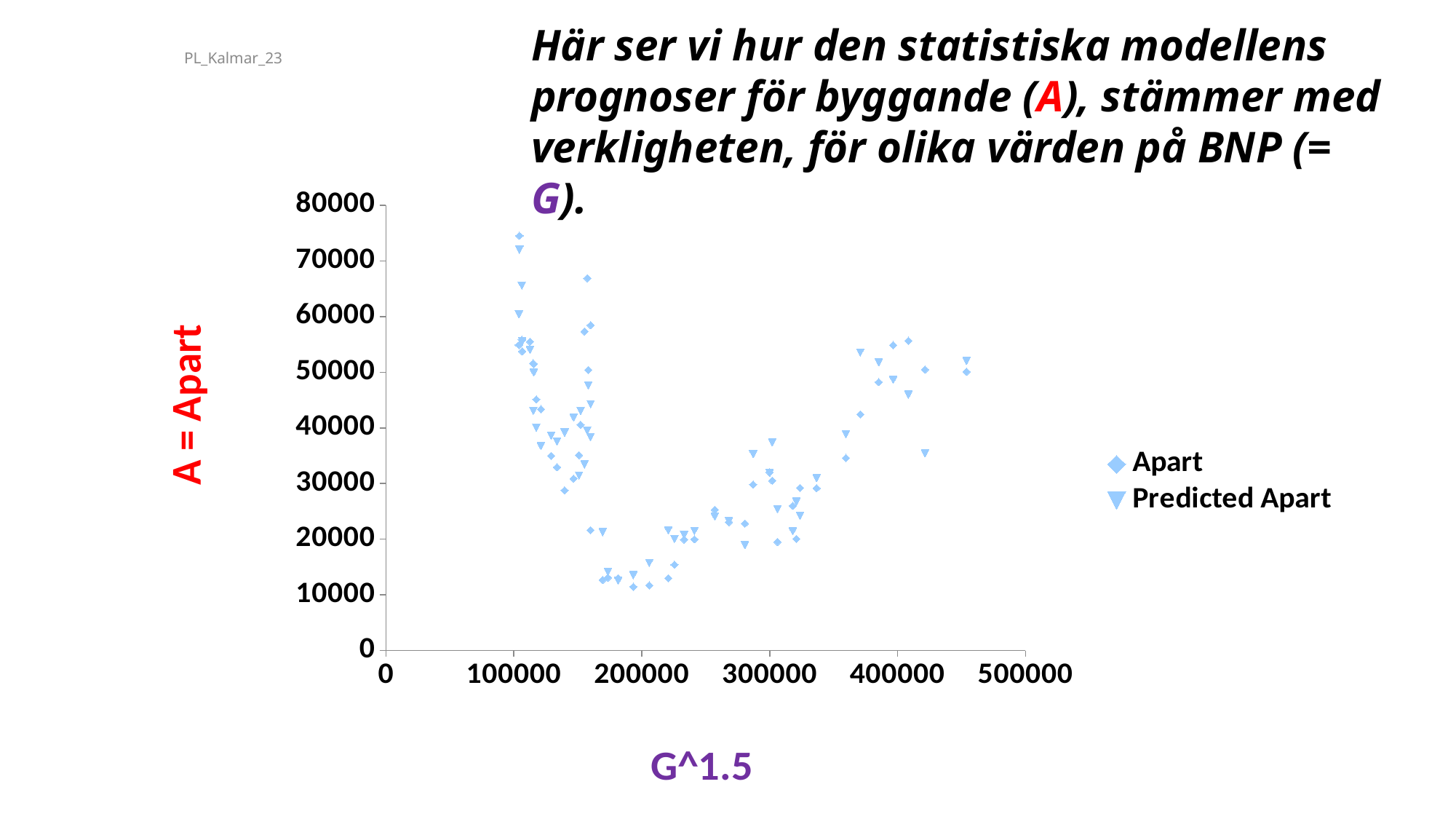
Is the lowest plotted point on the chart greater or less than 20000? less Do the plotted values generally rise or fall as G^1.5 increases from 100000 to 200000? fall Are the points plotted near G^1.5 = 400000 greater or less than 40000? greater How many series does the legend list? 2 Is the highest plotted point on the chart greater or less than 70000? greater What are the two series named in the legend? Apart and Predicted Apart What is the highest value shown on the horizontal axis? 500000 What is the highest value shown on the vertical axis? 80000 What is the label of the vertical axis? A = Apart What kind of chart is shown on the slide? scatter chart Do the plotted values generally rise or fall as G^1.5 increases from 200000 to 400000? rise